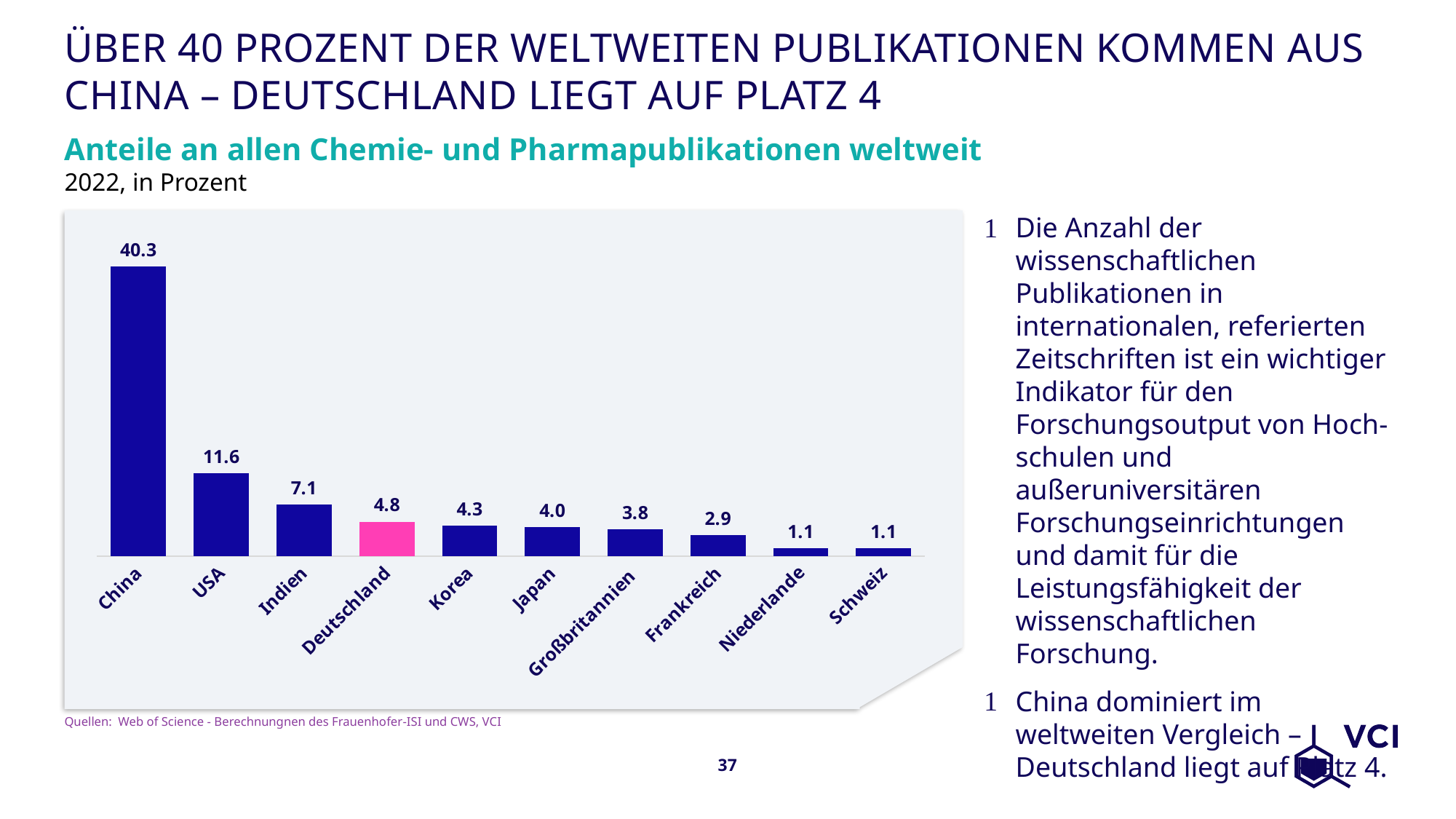
Which is larger, the value for Frankreich or the value for Indien? Indien What is the value for China? 40.3 Which country has the highest share? China Which country's bar is highlighted in pink? Deutschland What is the difference between the values for USA and Indien? 4.5 What is the value for Deutschland? 4.8 What is the difference between the values for China and Deutschland? 35.5 Which is larger, the value for Korea or the value for Japan? Korea What kind of chart is shown on the slide? Bar chart Do the values rise or fall from left to right across the chart? Fall What is the value for Großbritannien? 3.8 How many countries are shown in the chart? 10